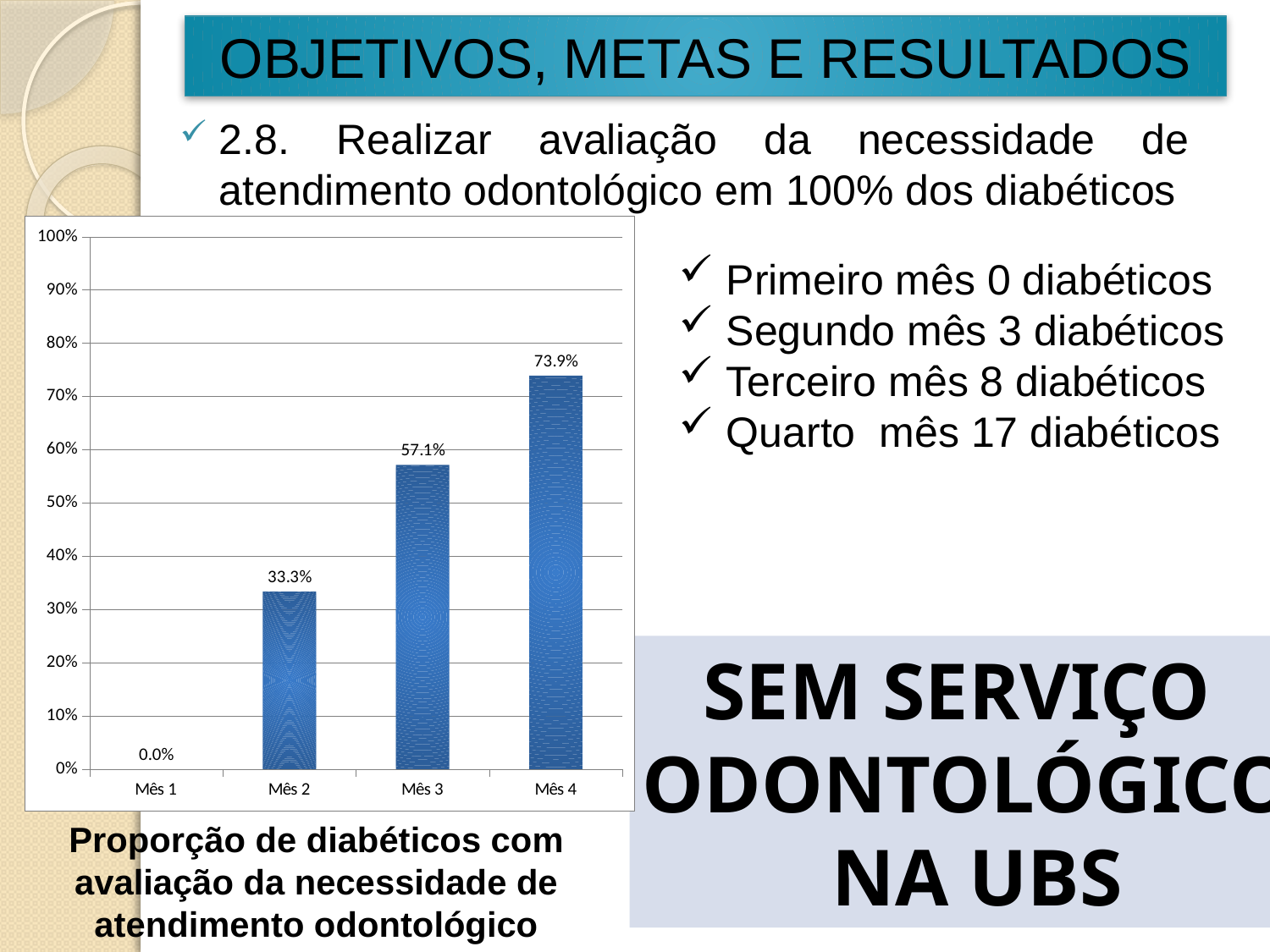
What is the value for Mês 4? 73.9% What kind of chart is shown? Bar chart What is the value for Mês 2? 33.3% Which month has the highest value? Mês 4 How many months are shown on the x axis? 4 Which is larger, the value for Mês 2 or the value for Mês 3? Mês 3 Which month has the lowest value? Mês 1 What is the value for Mês 1? 0.0% What is the value for Mês 3? 57.1% What is the difference between the values for Mês 4 and Mês 3? 16.8% Do the values rise or fall from Mês 1 to Mês 4? Rise Is the value for Mês 4 greater or less than 70%? greater